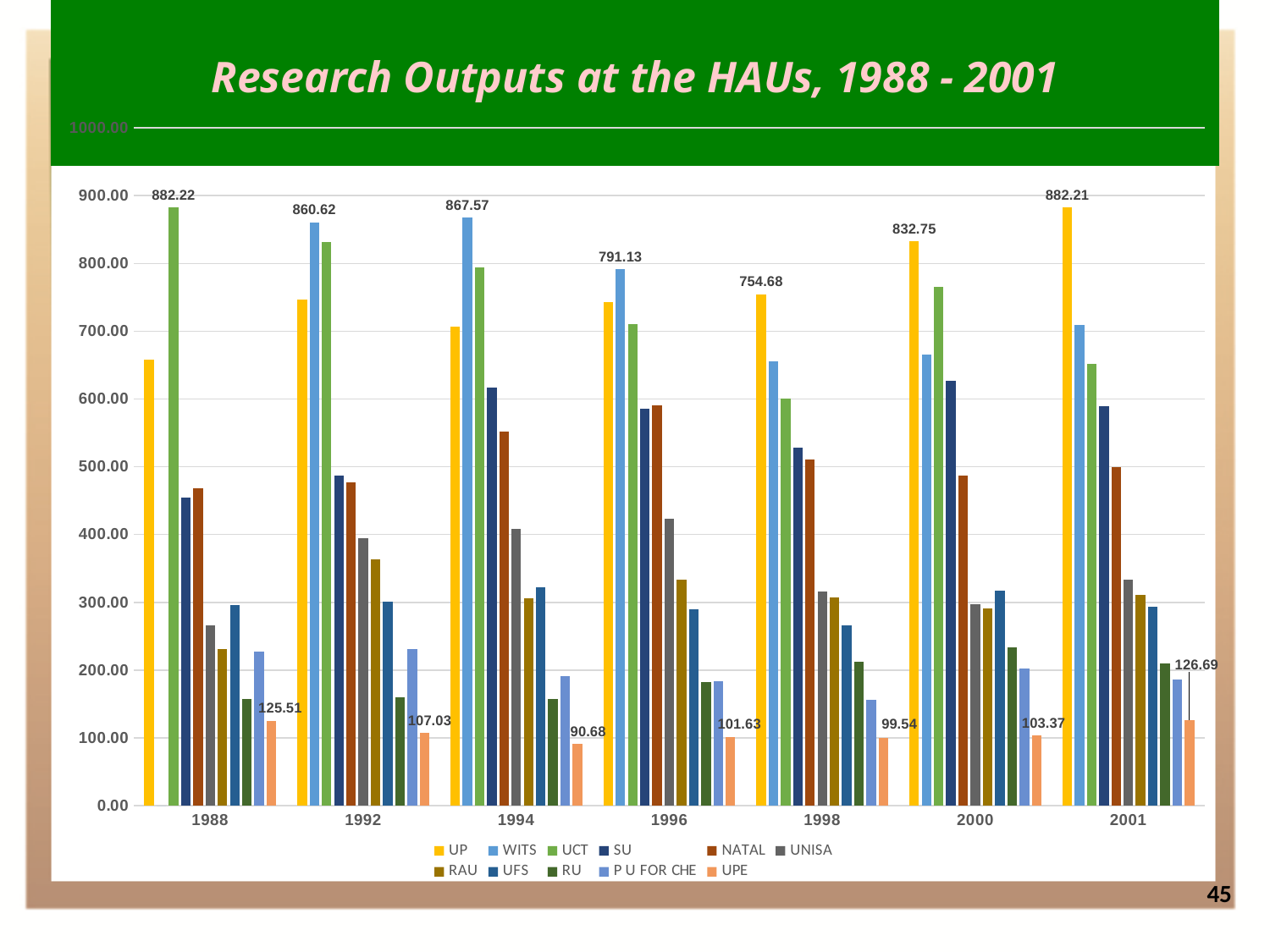
Which institution has the highest value in 1992? WITS What is the value for UP in 2001? 882.21 What is the value for UCT in 1988? 882.22 How many series does the legend list? 11 Which is larger, the UP value in 2000 or the UP value in 1998? UP in 2000 What is the difference between the UCT value and the UPE value in 1988? 756.71 What is the value for UPE in 1994? 90.68 Is the value for SU in 2000 greater or less than 600? greater Which institution has the lowest value in 1998? UPE How many years are shown on the x axis? 7 What kind of chart is shown on the slide? bar chart What is the title of the chart? Research Outputs at the HAUs, 1988 - 2001